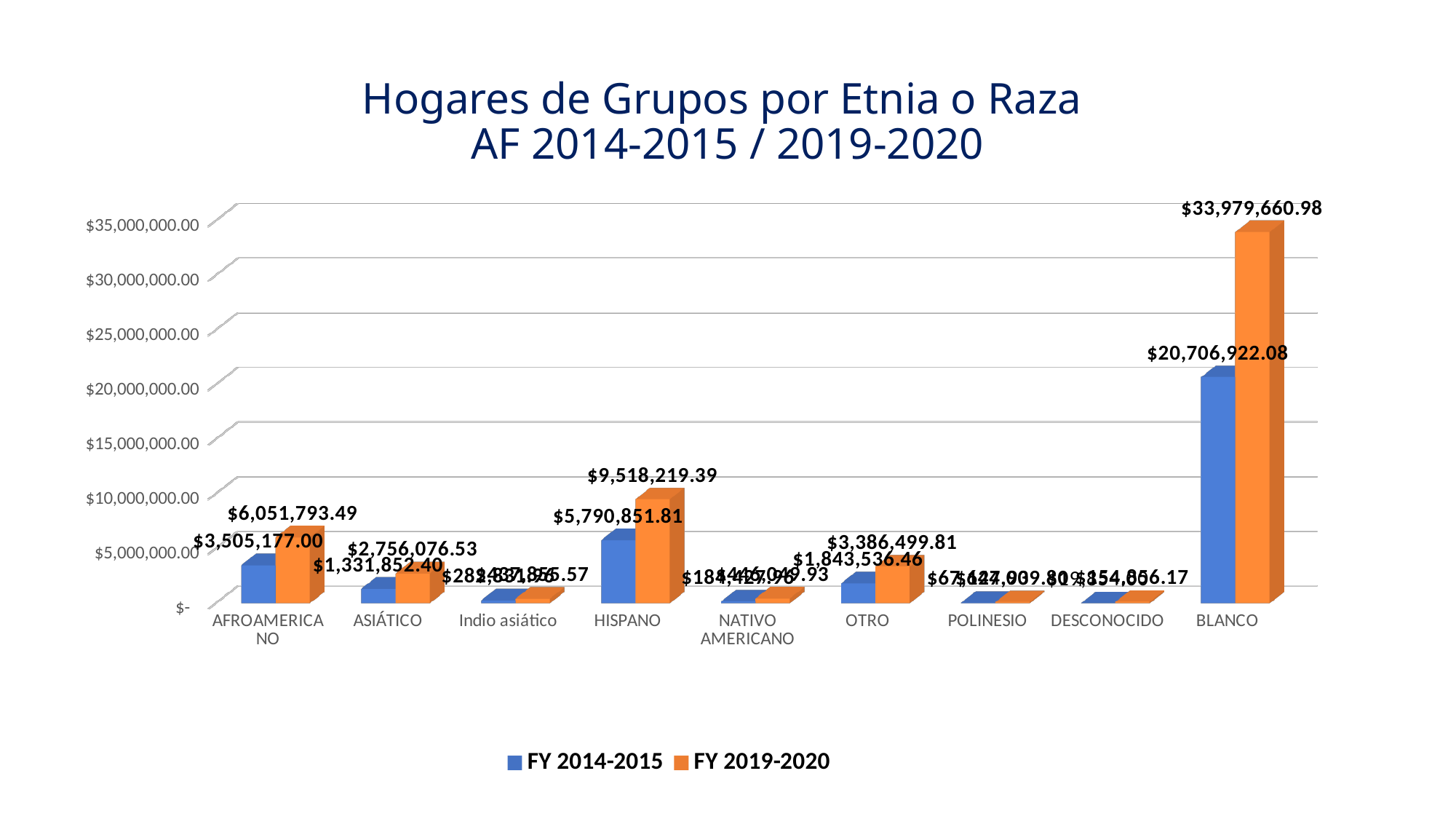
What is the difference between the FY 2019-2020 and FY 2014-2015 values for BLANCO? $13,272,738.90 What is the FY 2019-2020 value for OTRO? $3,386,499.81 What is the FY 2014-2015 value for ASIÁTICO? $1,331,852.40 What is the difference between the FY 2019-2020 and FY 2014-2015 values for HISPANO? $3,727,367.58 Which category has the highest FY 2019-2020 value? BLANCO What is the FY 2019-2020 value for BLANCO? $33,979,660.98 How many series does the legend list? 2 What is the FY 2014-2015 value for HISPANO? $5,790,851.81 How many categories are shown on the x axis? 9 Is the FY 2014-2015 value for BLANCO greater or less than $25,000,000.00? less Which is larger for AFROAMERICANO: the FY 2014-2015 value or the FY 2019-2020 value? FY 2019-2020 What is the FY 2019-2020 value for AFROAMERICANO? $6,051,793.49